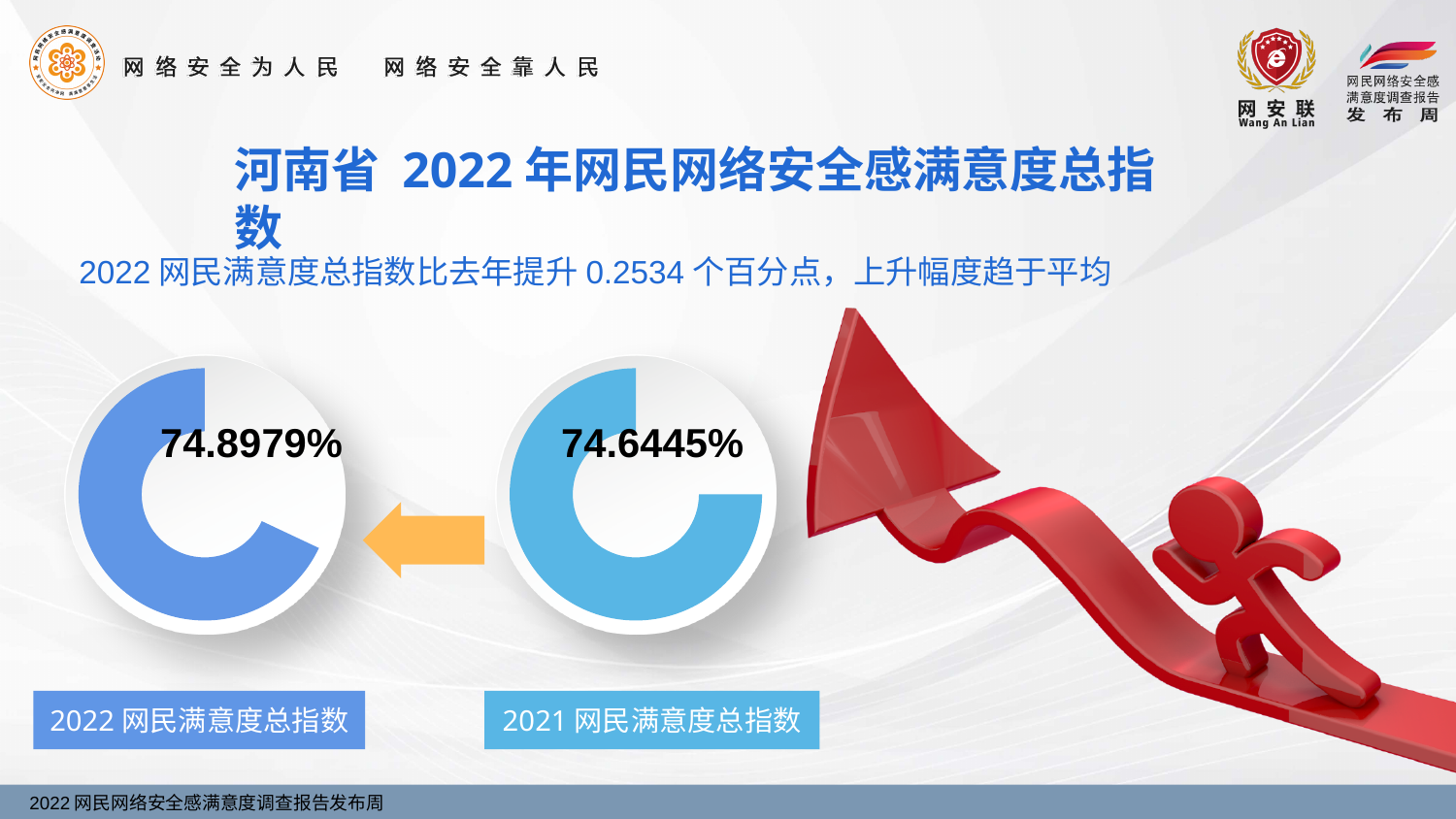
Which year's 网民满意度总指数 is higher, 2022 or 2021? 2022 What is the value shown in the right doughnut chart labelled 2021 网民满意度总指数? 74.6445% Did the 网民满意度总指数 rise or fall from 2021 to 2022? Rise What kind of chart is used to display the 2022 and 2021 satisfaction indices? Doughnut chart Which of the two doughnut charts shows the higher value? 2022 网民满意度总指数 What is the label under the right doughnut chart? 2021 网民满意度总指数 Which of the two doughnut charts shows the lower value? 2021 网民满意度总指数 What is the label under the left doughnut chart? 2022 网民满意度总指数 What is the value shown in the left doughnut chart labelled 2022 网民满意度总指数? 74.8979% By how many percentage points did the 网民满意度总指数 rise from 2021 to 2022? 0.2534 How many doughnut charts are shown on the slide? 2